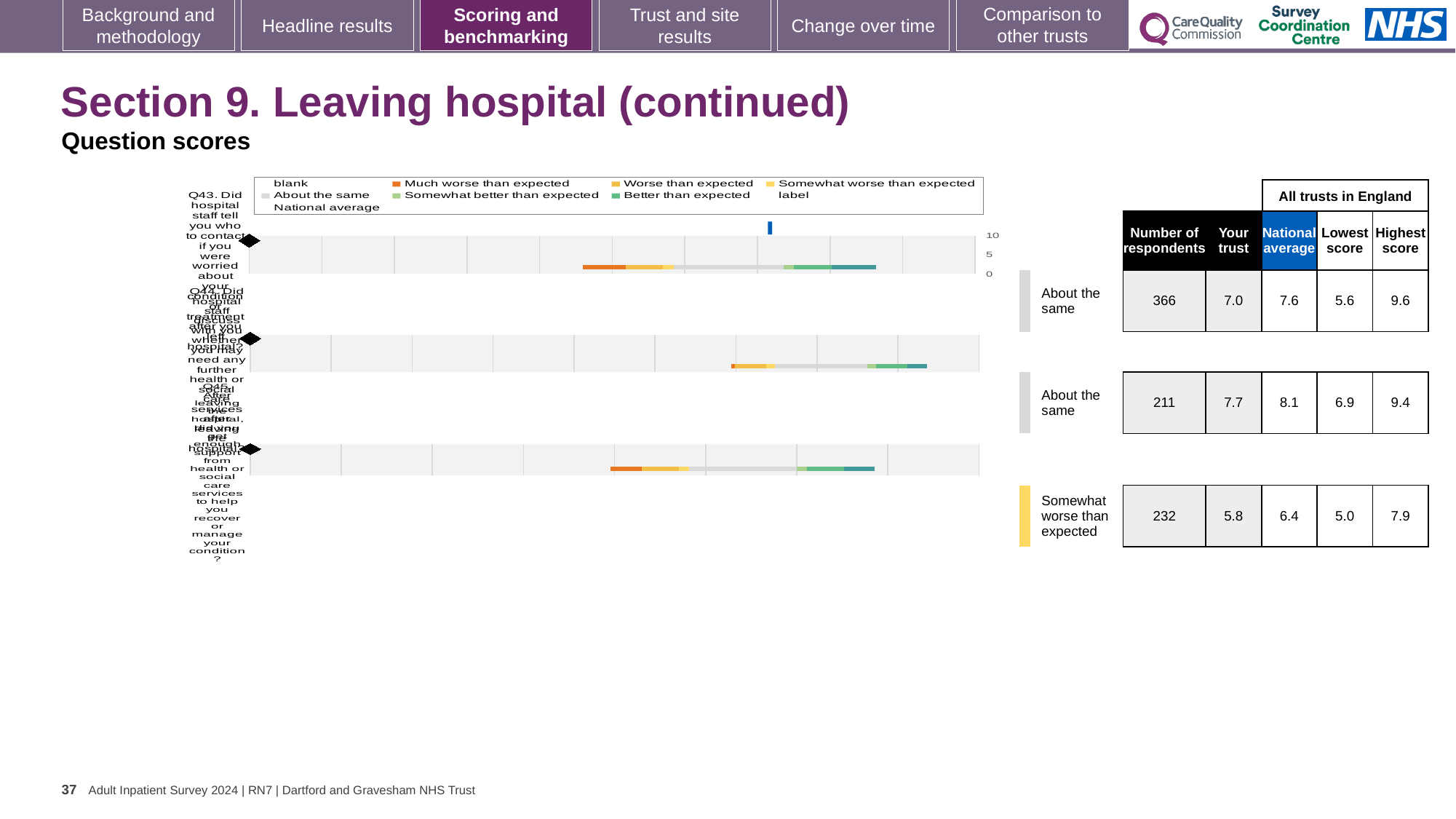
How many question score charts are shown on the slide? 3 For the top chart (Q43), what is the 'Your trust' score shown in the table? 7.0 For the bottom chart (Q45), what is the highest score among all trusts in England? 7.9 For the bottom chart (Q45), what is the difference between the national average and the 'Your trust' score? 0.6 For the top chart (Q43), what is the national average score? 7.6 What benchmark category is shown next to the bottom chart (Q45)? Somewhat worse than expected For the middle chart (Q44), is the 'Your trust' score or the national average larger? national average Which of the three charts has the lowest 'Your trust' score? the bottom chart (Q45) In the legend, what colour represents 'Much worse than expected'? orange For the middle chart (Q44), how many respondents are listed? 211 What kind of chart is used to show the question scores on this slide? bar chart Which of the three charts has the highest 'Your trust' score? the middle chart (Q44)